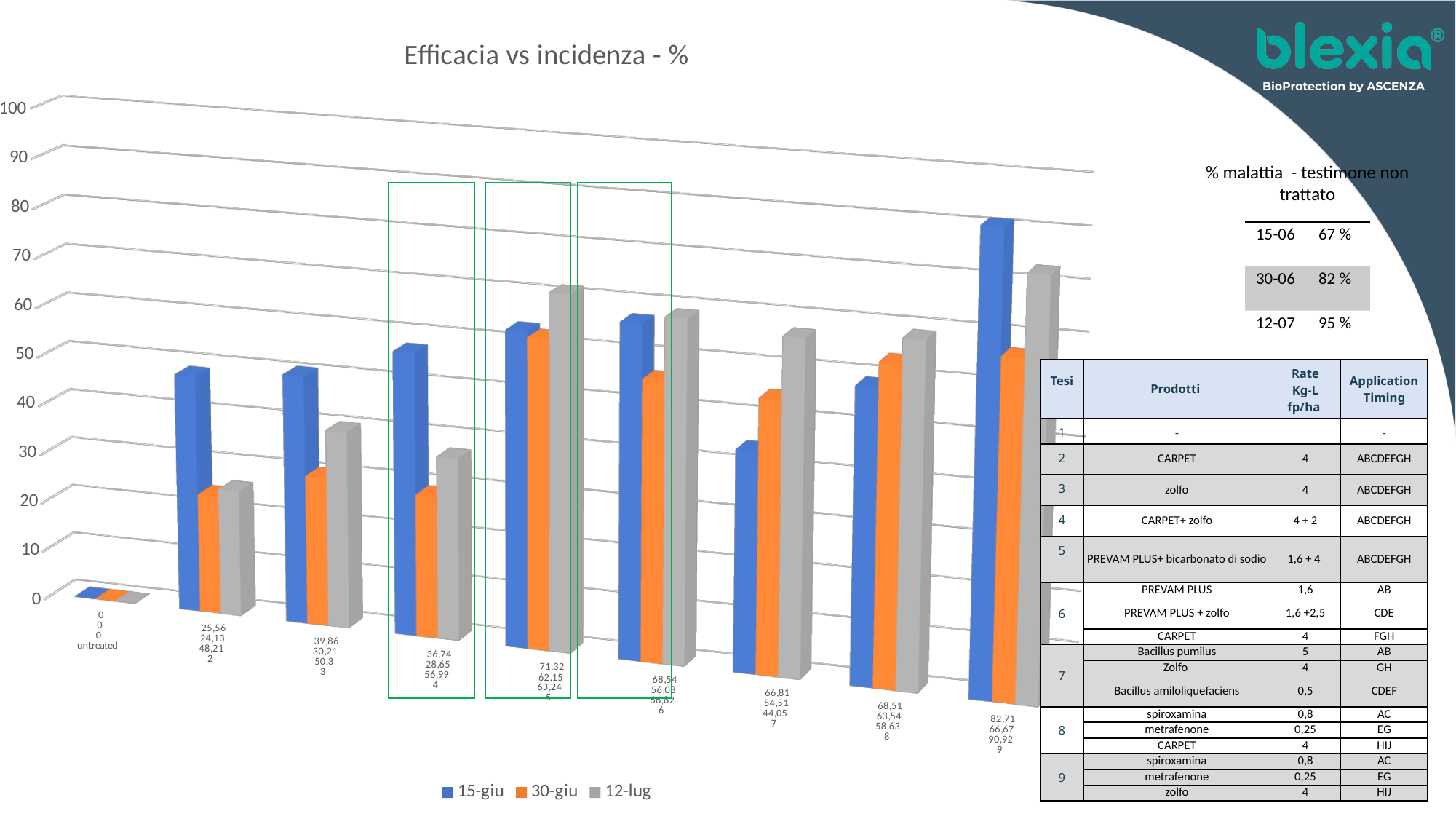
What is the difference between the 15-giu and 30-giu values for category 4? 28,34 What is the 30-giu value for category 2? 24,13 What kind of chart is shown on the slide? bar chart Which is larger for category 7: the 15-giu value or the 12-lug value? 12-lug What is the 12-lug value for category 5? 71,32 What is the 15-giu value for category 9? 90,92 Which category has the highest 12-lug value? 9 Which category has the lowest 15-giu value? untreated What is the title of the chart? Efficacia vs incidenza - % How many series does the chart legend list? 3 Is the 15-giu value for category 9 greater or less than 70? greater How many categories are plotted along the x axis of the chart? 9